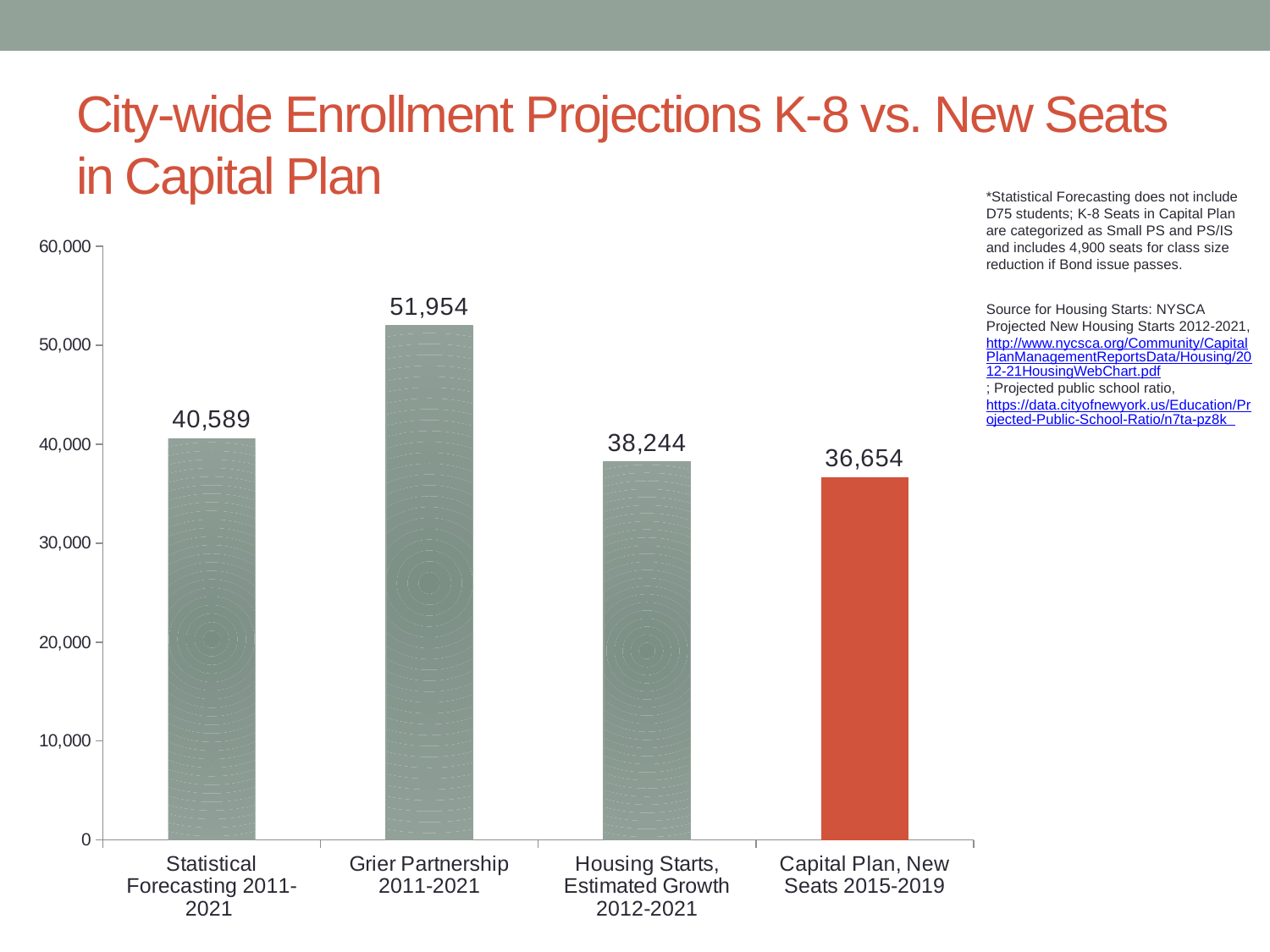
What is the value for Grier Partnership 2011-2021? 51,954 What kind of chart is shown on the slide? Bar chart Which is larger, the value for Statistical Forecasting 2011-2021 or the value for Housing Starts, Estimated Growth 2012-2021? Statistical Forecasting 2011-2021 How many categories are shown on the chart? 4 Which category has the lowest value? Capital Plan, New Seats 2015-2019 Which category has the highest value? Grier Partnership 2011-2021 What is the value for Capital Plan, New Seats 2015-2019? 36,654 What is the value for Statistical Forecasting 2011-2021? 40,589 What is the difference between the Grier Partnership 2011-2021 value and the Capital Plan, New Seats 2015-2019 value? 15,300 Is the value for Grier Partnership 2011-2021 greater or less than 50,000? greater What is the difference between the Statistical Forecasting 2011-2021 value and the Housing Starts, Estimated Growth 2012-2021 value? 2,345 What is the value for Housing Starts, Estimated Growth 2012-2021? 38,244